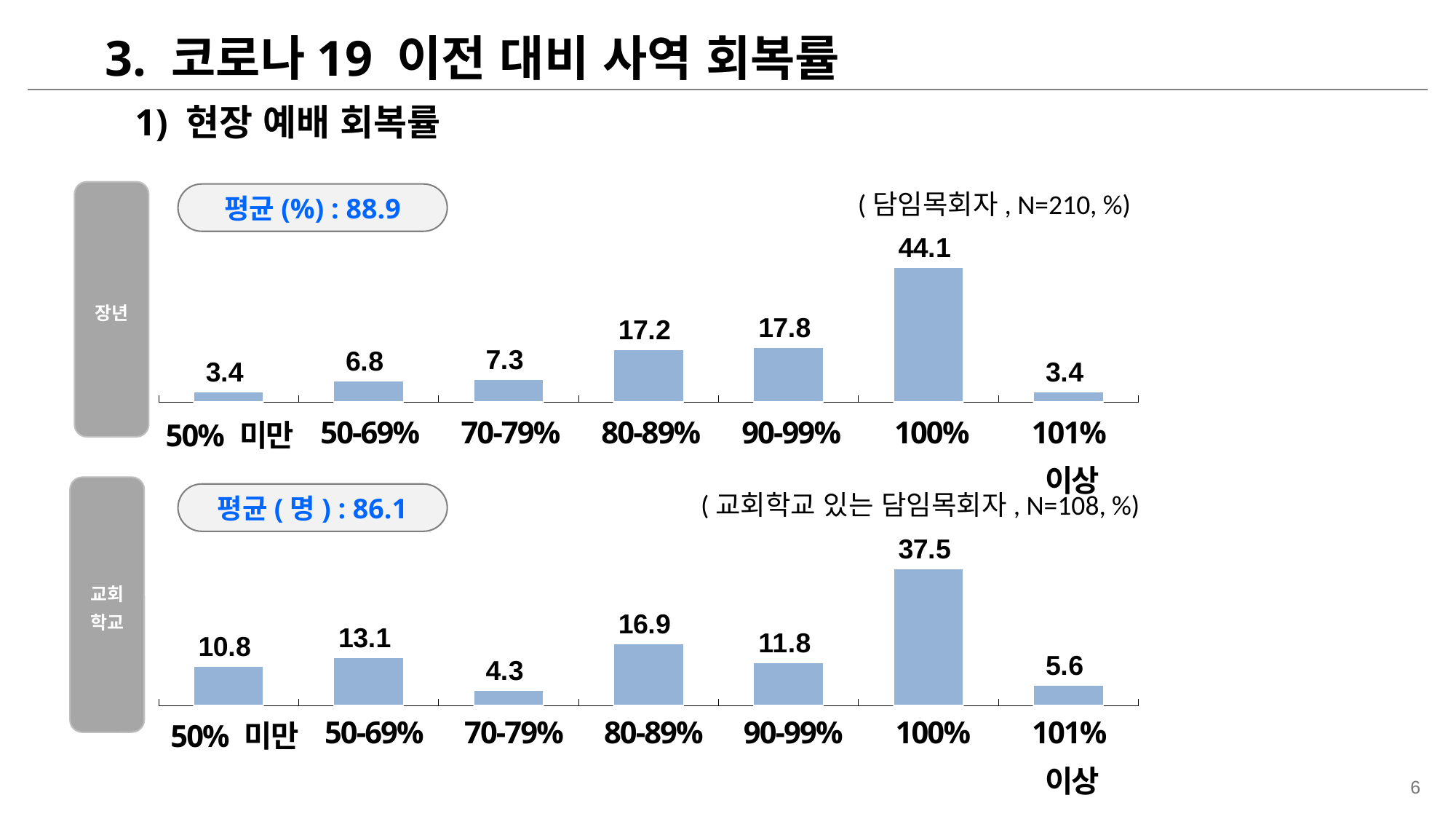
In the bottom chart (교회학교), which category has the lowest value? 70-79% What average value is shown in the rounded box above the top chart (장년)? 88.9 What kind of chart is the bottom chart (교회학교)? bar chart In the bottom chart (교회학교), which is larger, the value for 50% 미만 or the value for 101% 이상? 50% 미만 How many categories are shown on the x axis of the top chart (장년)? 7 In the top chart (장년), what is the value for the 100% category? 44.1 In the top chart (장년), which is larger, the value for 80-89% or the value for 70-79%? 80-89% What is the sample size (N) stated for the bottom chart (교회학교)? 108 In the top chart (장년), which category has the highest value? 100% In the bottom chart (교회학교), what is the value for the 50-69% category? 13.1 In the bottom chart (교회학교), what is the difference between the values for 80-89% and 90-99%? 5.1 In the top chart (장년), what is the difference between the values for 100% and 90-99%? 26.3